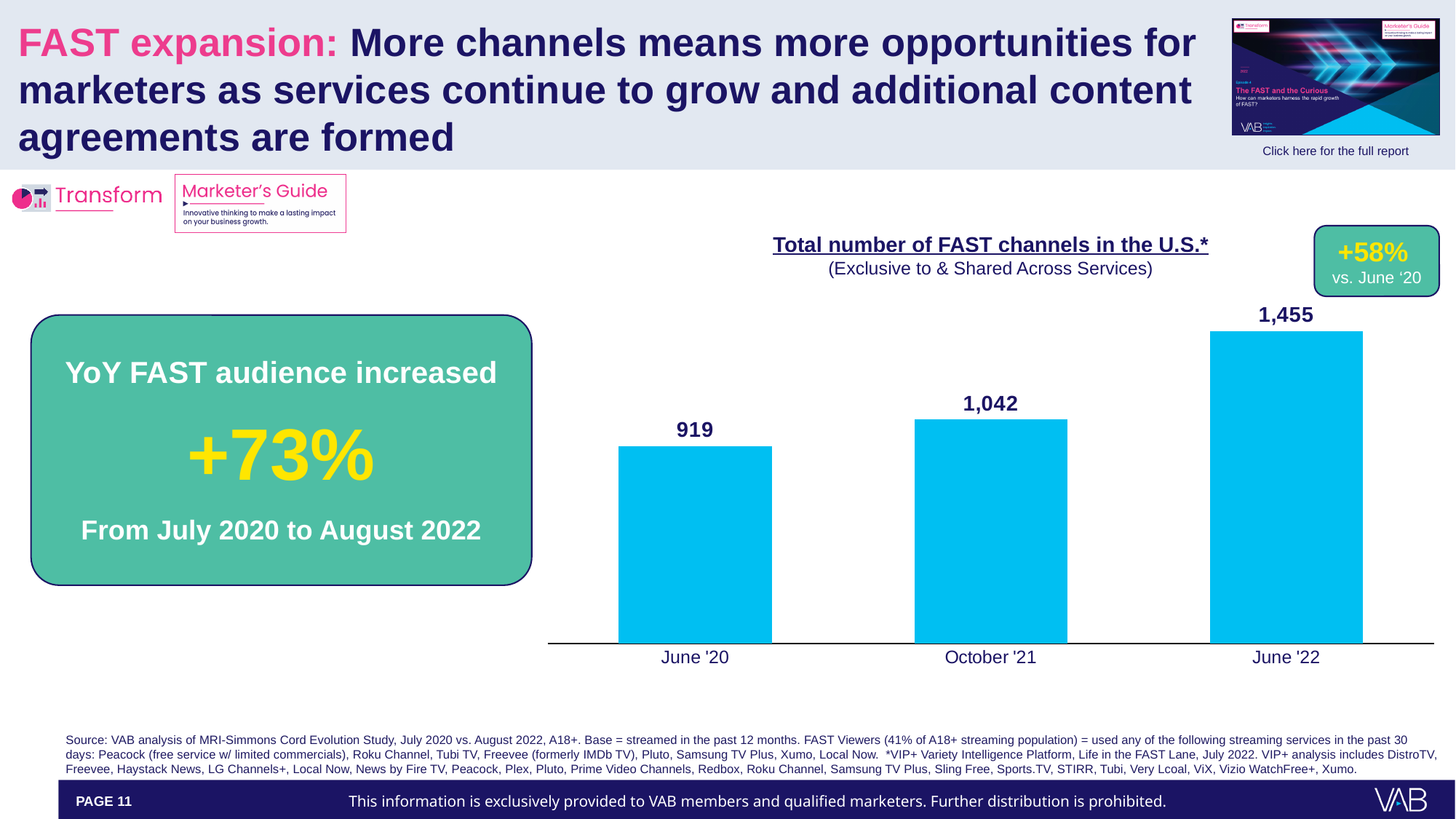
What is the difference in the number of FAST channels between June '22 and June '20? 536 What is the difference in the number of FAST channels between October '21 and June '20? 123 What is the total number of FAST channels in the U.S. in June '20? 919 How many periods are shown in the chart? 3 Do the number of FAST channels rise or fall from June '20 to June '22? Rise Which has more FAST channels, October '21 or June '22? June '22 Which period has the highest number of FAST channels? June '22 What is the total number of FAST channels in the U.S. in October '21? 1,042 What kind of chart is used to show the total number of FAST channels? Bar chart What is the title of the chart? Total number of FAST channels in the U.S.* Which period has the lowest number of FAST channels? June '20 What is the total number of FAST channels in the U.S. in June '22? 1,455